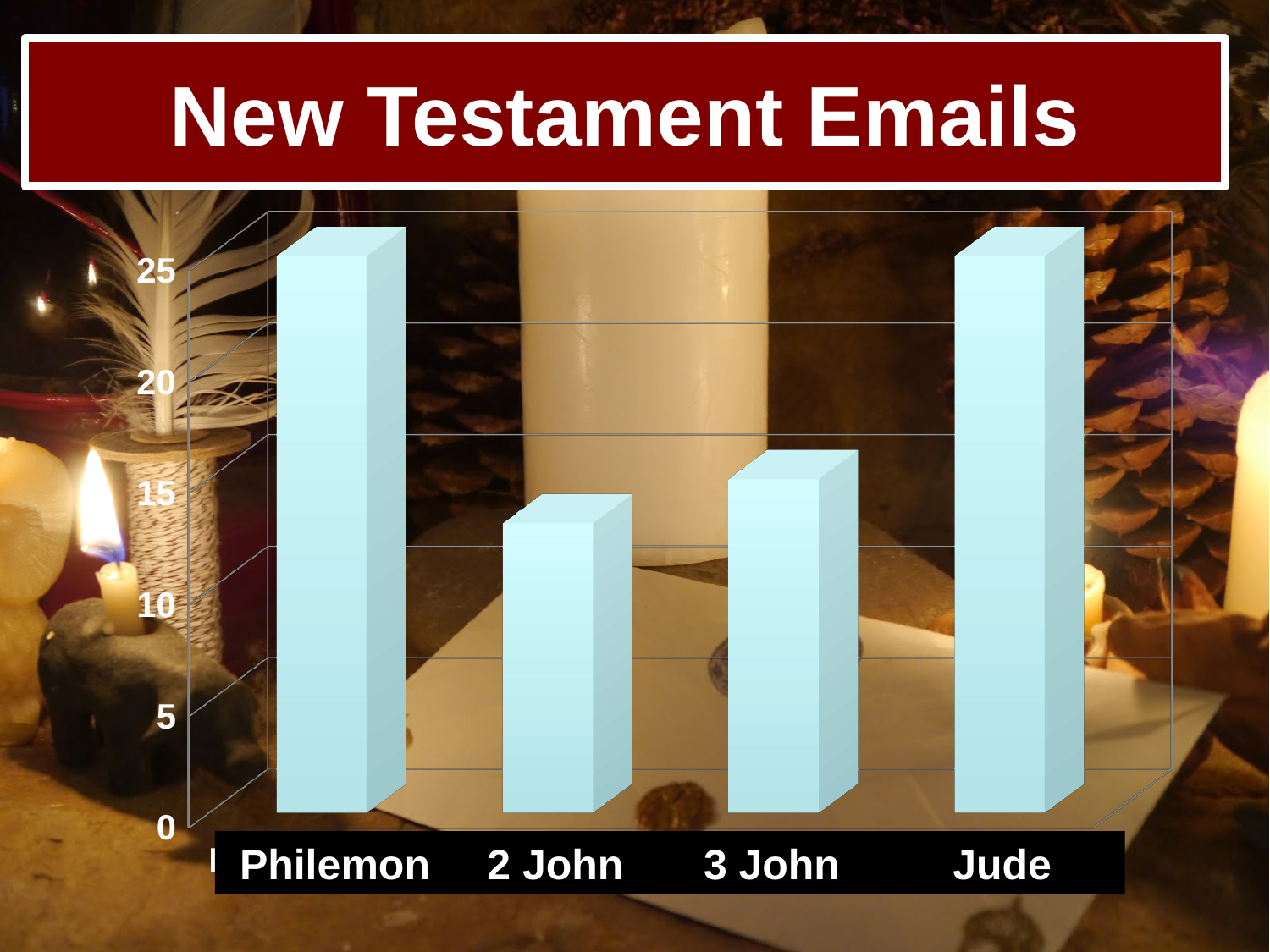
What is the title of the slide? New Testament Emails Is the value for Jude greater or less than 20? greater What is the highest value shown on the vertical axis? 25 Is the value for 2 John greater or less than 20? less Which category has the lowest value? 2 John Is the value for Philemon greater or less than 20? greater What kind of chart is shown on the slide? bar chart Which is larger, the value for 2 John or the value for 3 John? 3 John How many categories are plotted on the chart? 4